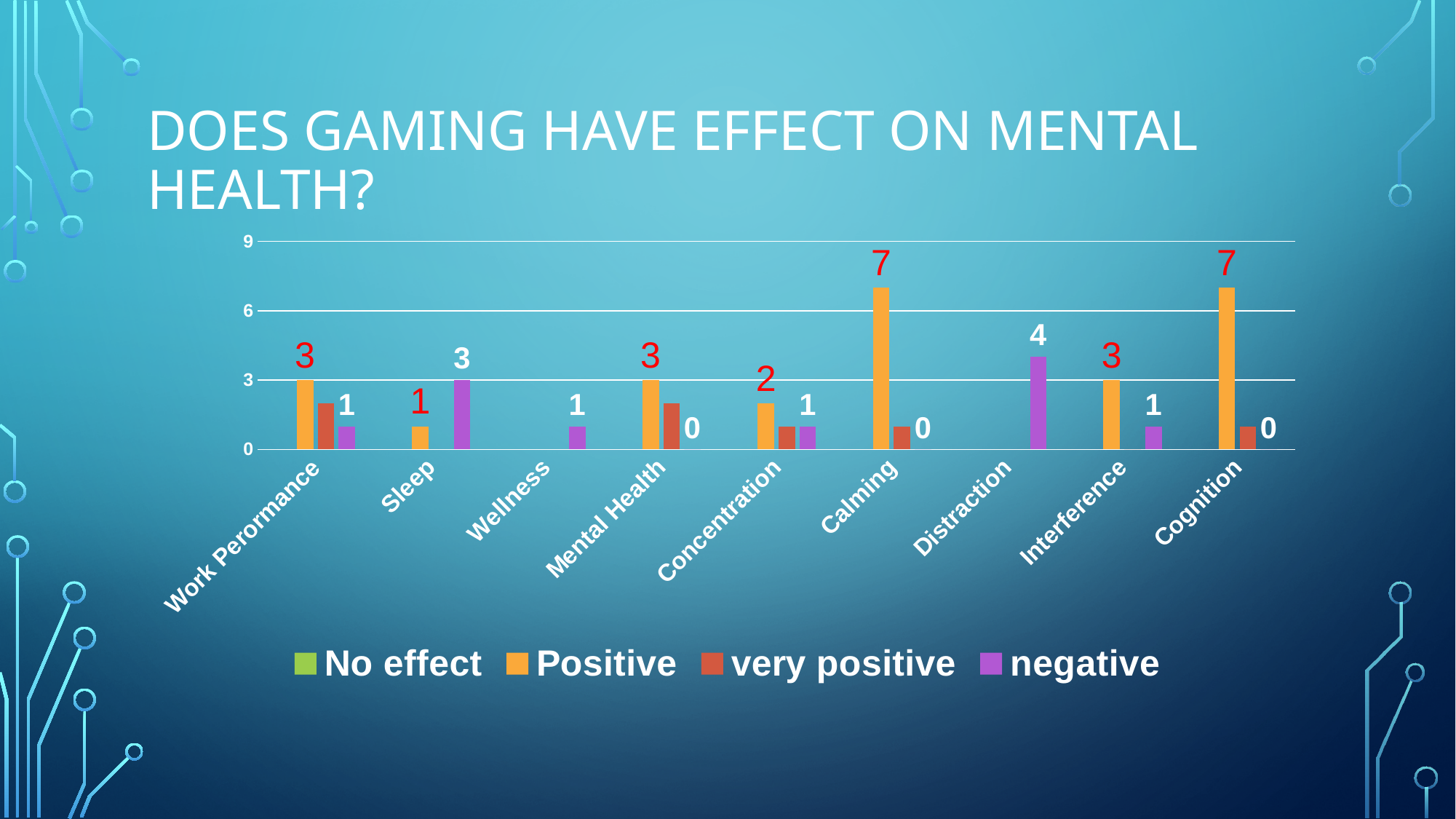
What is the Positive value for Calming? 7 How many categories are shown along the x axis of the chart? 9 What colour represents the Positive series in the legend? orange What is the negative value for Sleep? 3 What is the negative value for Distraction? 4 What kind of chart is shown on the slide? bar chart What is the difference between the Positive value for Calming and the Positive value for Concentration? 5 Is the very positive value for Work Perormance greater or less than 3? less Which is larger, the Positive value for Work Perormance or the Positive value for Sleep? Work Perormance Which category has the highest negative value? Distraction What is the Positive value for Interference? 3 How many series does the chart's legend list? 4